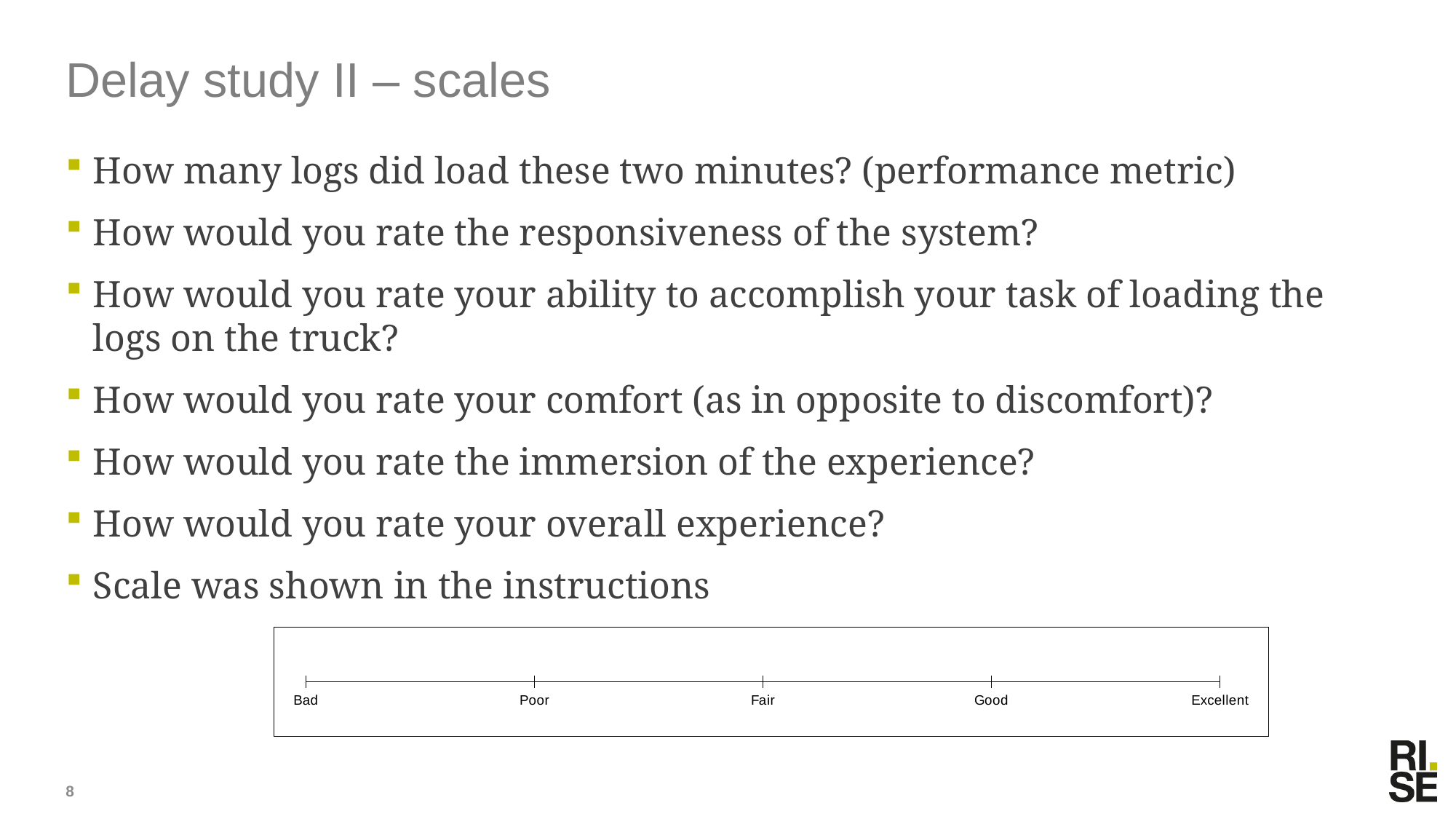
How many labelled points are on the rating scale shown at the bottom of the slide? 5 Which label sits at the middle tick of the rating scale shown on the slide? Fair What is the label at the right end of the rating scale shown on the slide? Excellent What is the label at the left end of the rating scale shown on the slide? Bad